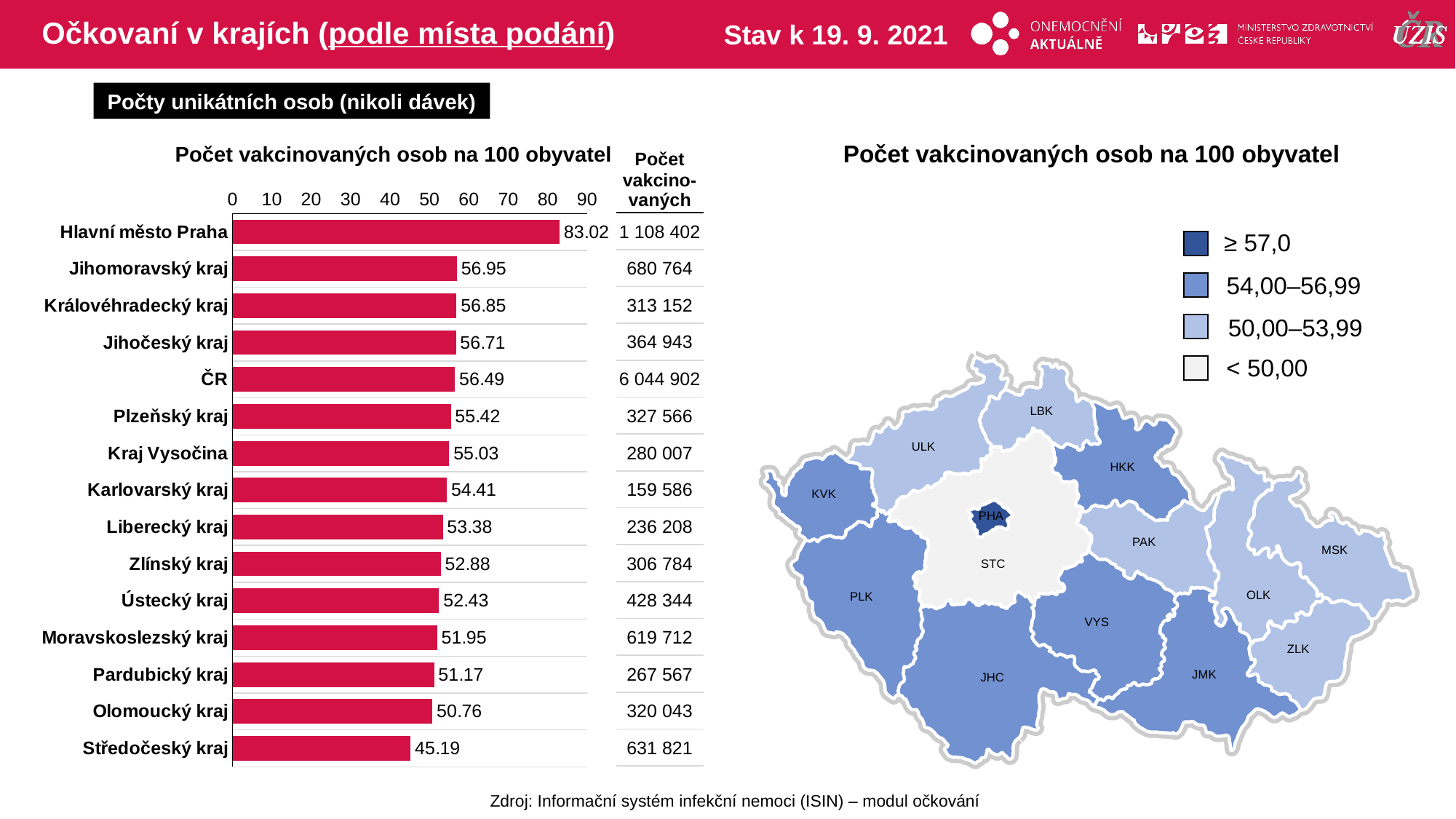
In the bar chart, what is the difference between the values for Hlavní město Praha and Středočeský kraj? 37.83 Which category has the lowest value in the bar chart? Středočeský kraj How many categories (bars) are shown in the bar chart? 15 In the bar chart, what is the value for Hlavní město Praha? 83.02 In the bar chart, what is the difference between the values for Jihomoravský kraj and Královéhradecký kraj? 0.10 In the bar chart, what is the value for ČR? 56.49 In the bar chart, is the value for Liberecký kraj greater or less than 50? greater In the bar chart, which has the larger value: Plzeňský kraj or Kraj Vysočina? Plzeňský kraj Which category has the highest value in the bar chart? Hlavní město Praha What kind of chart is shown on the left of the slide? bar chart In the bar chart, what is the value for Olomoucký kraj? 50.76 What is the title of the bar chart on the left? Počet vakcinovaných osob na 100 obyvatel